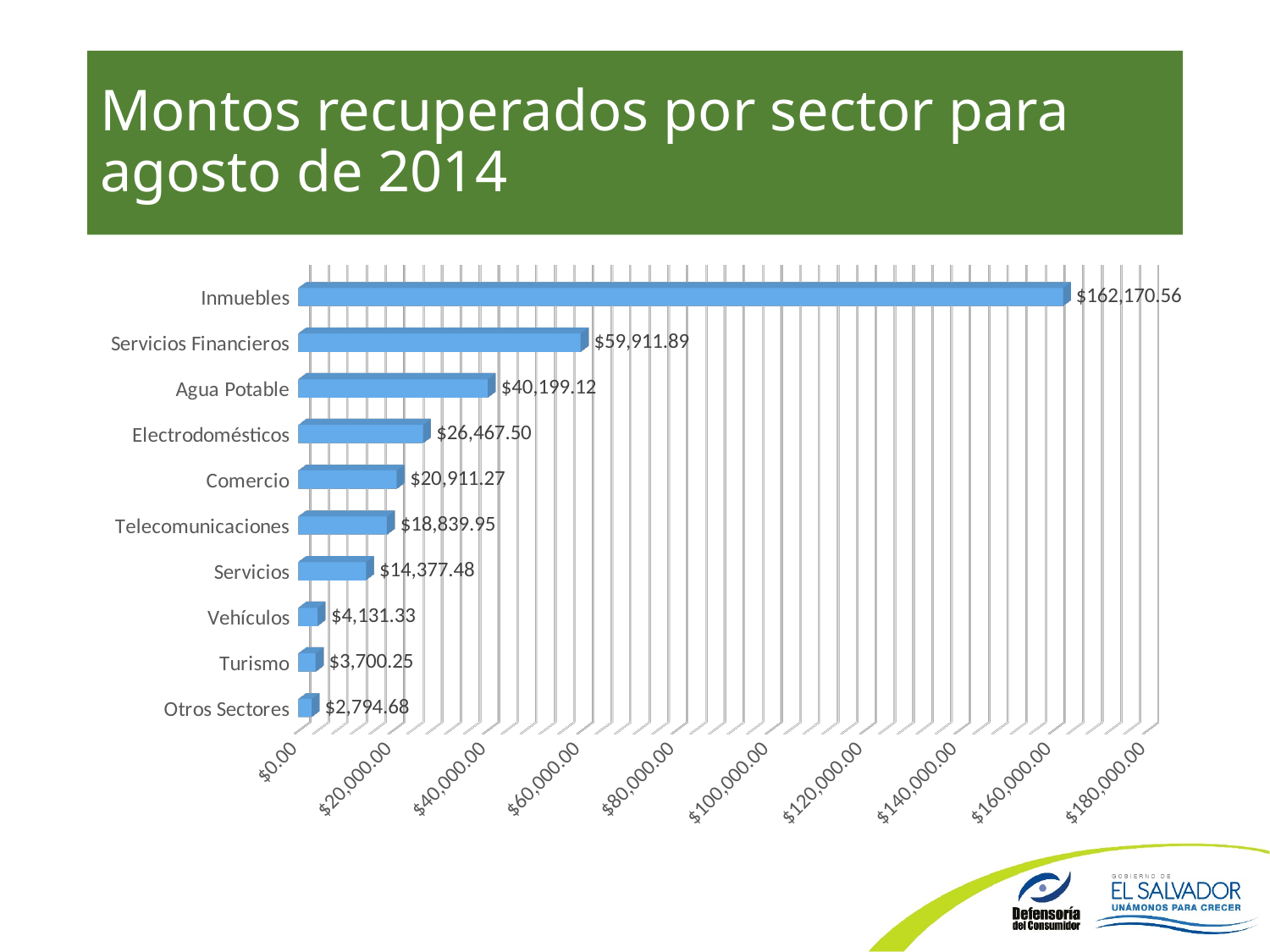
Which is larger, the value for Comercio or the value for Servicios? Comercio What is the difference between the values for Inmuebles and Servicios Financieros? $102,258.67 What is the value for Turismo? $3,700.25 Is the value for Servicios Financieros greater or less than $60,000.00? less Which sector has the highest recovered amount? Inmuebles How many sectors are shown in the chart? 10 Which sector has the lowest recovered amount? Otros Sectores What kind of chart is shown on the slide? bar chart What is the value for Inmuebles? $162,170.56 What is the difference between the values for Agua Potable and Electrodomésticos? $13,731.62 What is the value for Agua Potable? $40,199.12 What is the value for Telecomunicaciones? $18,839.95